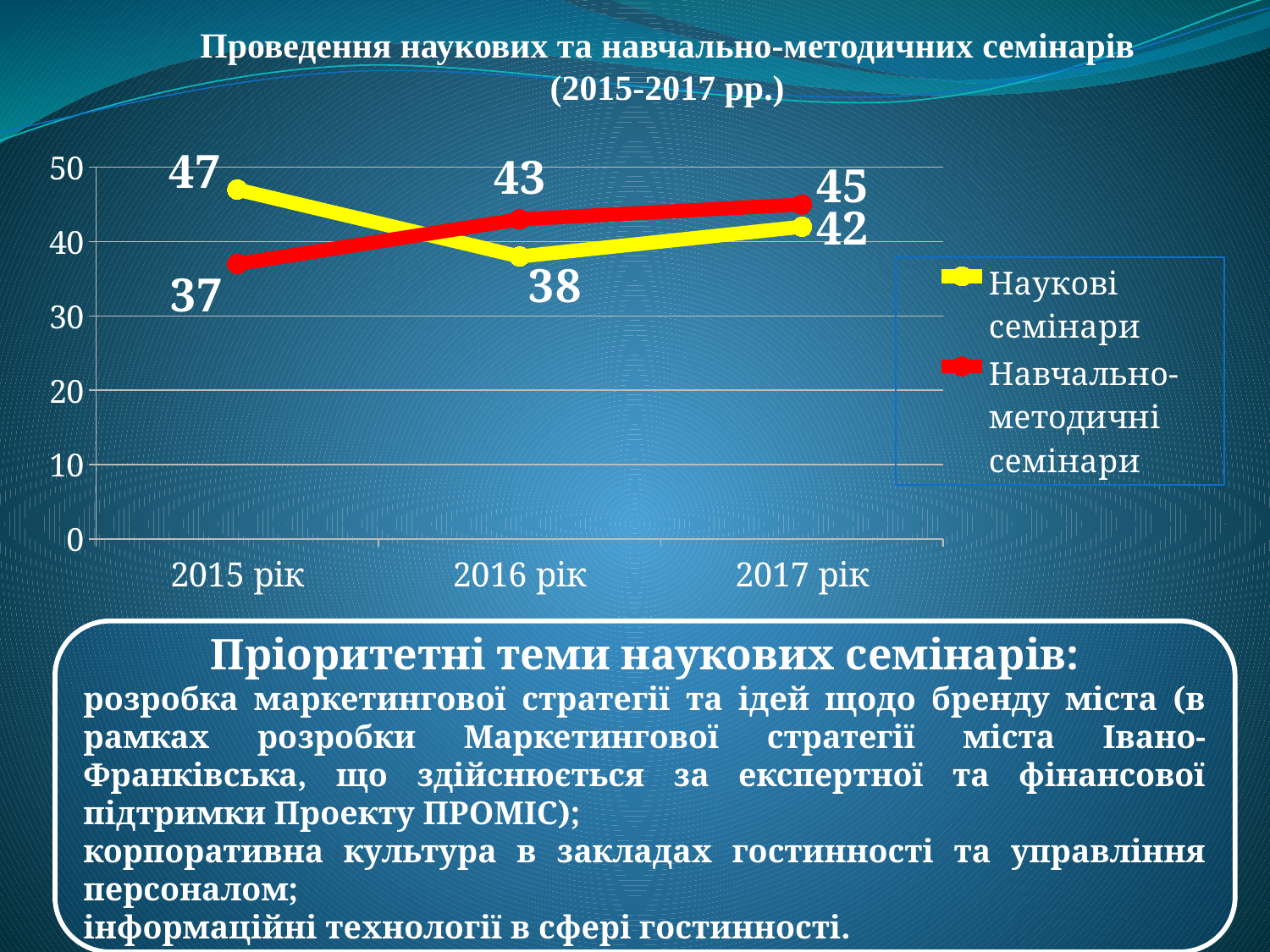
In which year is the value for Наукові семінари lowest? 2016 рік Is the value for Навчально-методичні семінари in 2015 рік greater or less than 40? less What is the value for Наукові семінари in 2015 рік? 47 What kind of chart is shown on the slide? line chart Which series has the larger value in 2017 рік? Навчально-методичні семінари How many series does the legend list? 2 What is the value for Навчально-методичні семінари in 2016 рік? 43 What is the value for Наукові семінари in 2017 рік? 42 Does the value for Навчально-методичні семінари rise or fall from 2015 рік to 2017 рік? rise In which year is the value for Навчально-методичні семінари highest? 2017 рік What is the difference between Наукові семінари and Навчально-методичні семінари in 2015 рік? 10 How many years are shown on the x axis? 3